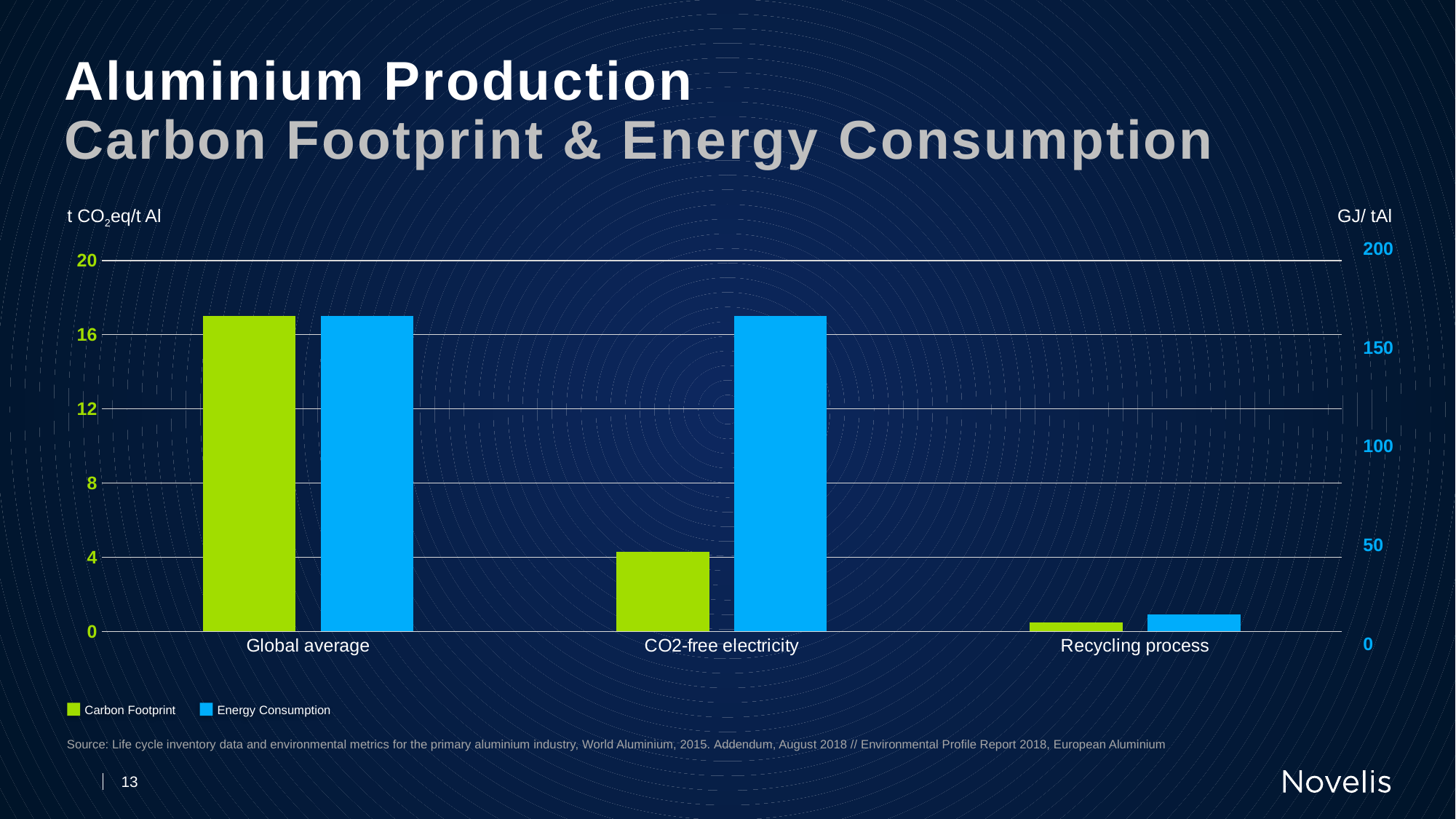
Is the Energy Consumption value for Recycling process greater or less than 50? less Do the Carbon Footprint values rise or fall from Global average to Recycling process? fall Which category has the highest Carbon Footprint value? Global average Which category has the lowest Carbon Footprint value? Recycling process Which is larger, the Carbon Footprint for Global average or for CO2-free electricity? Global average What kind of chart is shown on the slide? Bar chart Is the Carbon Footprint value for CO2-free electricity greater or less than 8? less Is the Carbon Footprint value for Global average greater or less than 16? greater How many series does the chart's legend list? 2 Which category has the lowest Energy Consumption value? Recycling process What unit is shown on the right-hand axis of the chart? GJ/ tAl How many categories are shown on the x axis of the chart? 3